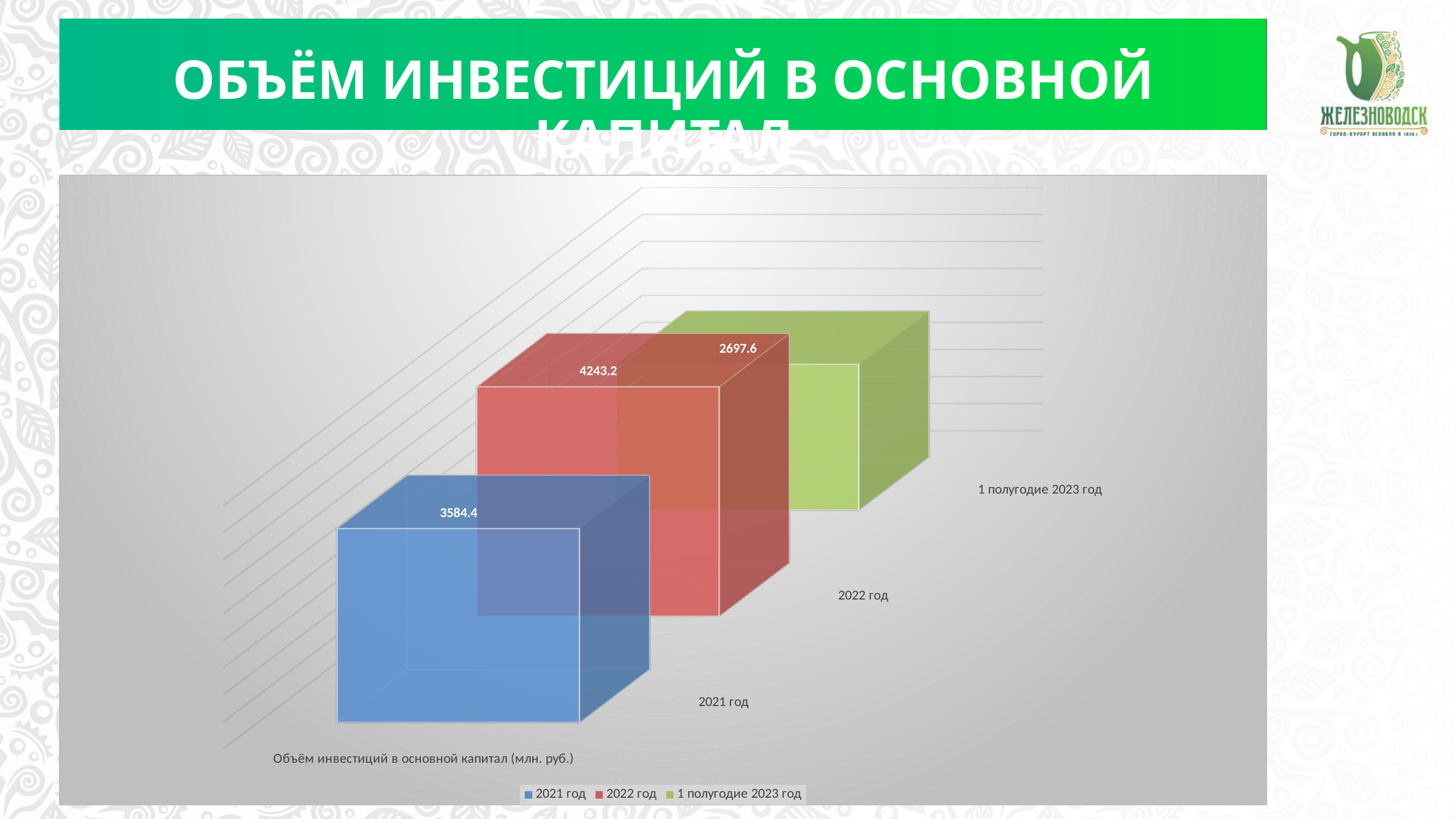
What is the value for 1 полугодие 2023 год? 2697.6 What is the value for 2021 год? 3584.4 What is the value for 2022 год? 4243.2 What colour is the bar for 2022 год? red Which series has the lowest value? 1 полугодие 2023 год What kind of chart is shown on the slide? bar chart What is the label of the category axis? Объём инвестиций в основной капитал (млн. руб.) What is the difference between the values for 2022 год and 1 полугодие 2023 год? 1545.6 What is the difference between the values for 2022 год and 2021 год? 658.8 Which series has the highest value? 2022 год How many series does the legend list? 3 Which is larger, the value for 2021 год or the value for 1 полугодие 2023 год? 2021 год